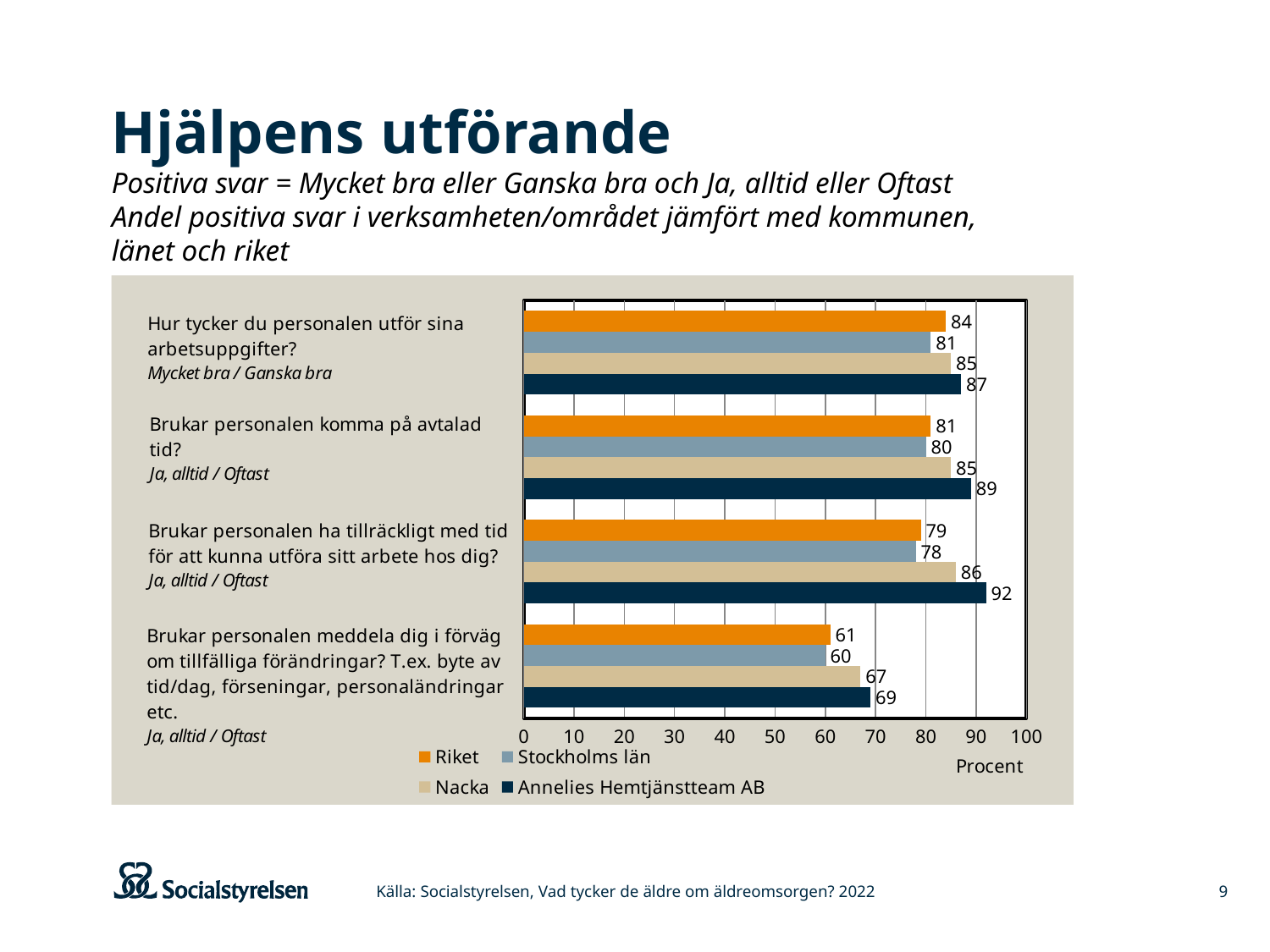
What is the value for Annelies Hemtjänstteam AB for 'Brukar personalen ha tillräckligt med tid för att kunna utföra sitt arbete hos dig?' 92 Which series has the highest value for 'Brukar personalen komma på avtalad tid?' Annelies Hemtjänstteam AB Which is larger for 'Hur tycker du personalen utför sina arbetsuppgifter?': Nacka or Stockholms län? Nacka What is the difference between Annelies Hemtjänstteam AB and Riket for 'Brukar personalen meddela dig i förväg om tillfälliga förändringar?' 8 How many question categories are plotted in the chart? 4 What kind of chart is shown on the slide? Bar chart How many series does the legend list? 4 What is the value for Stockholms län for 'Brukar personalen meddela dig i förväg om tillfälliga förändringar?' 60 What is the label of the x axis? Procent What is the value for Nacka for 'Brukar personalen komma på avtalad tid?' 85 Which series has the lowest value for 'Brukar personalen ha tillräckligt med tid för att kunna utföra sitt arbete hos dig?' Stockholms län What is the value for Riket for 'Hur tycker du personalen utför sina arbetsuppgifter?' 84